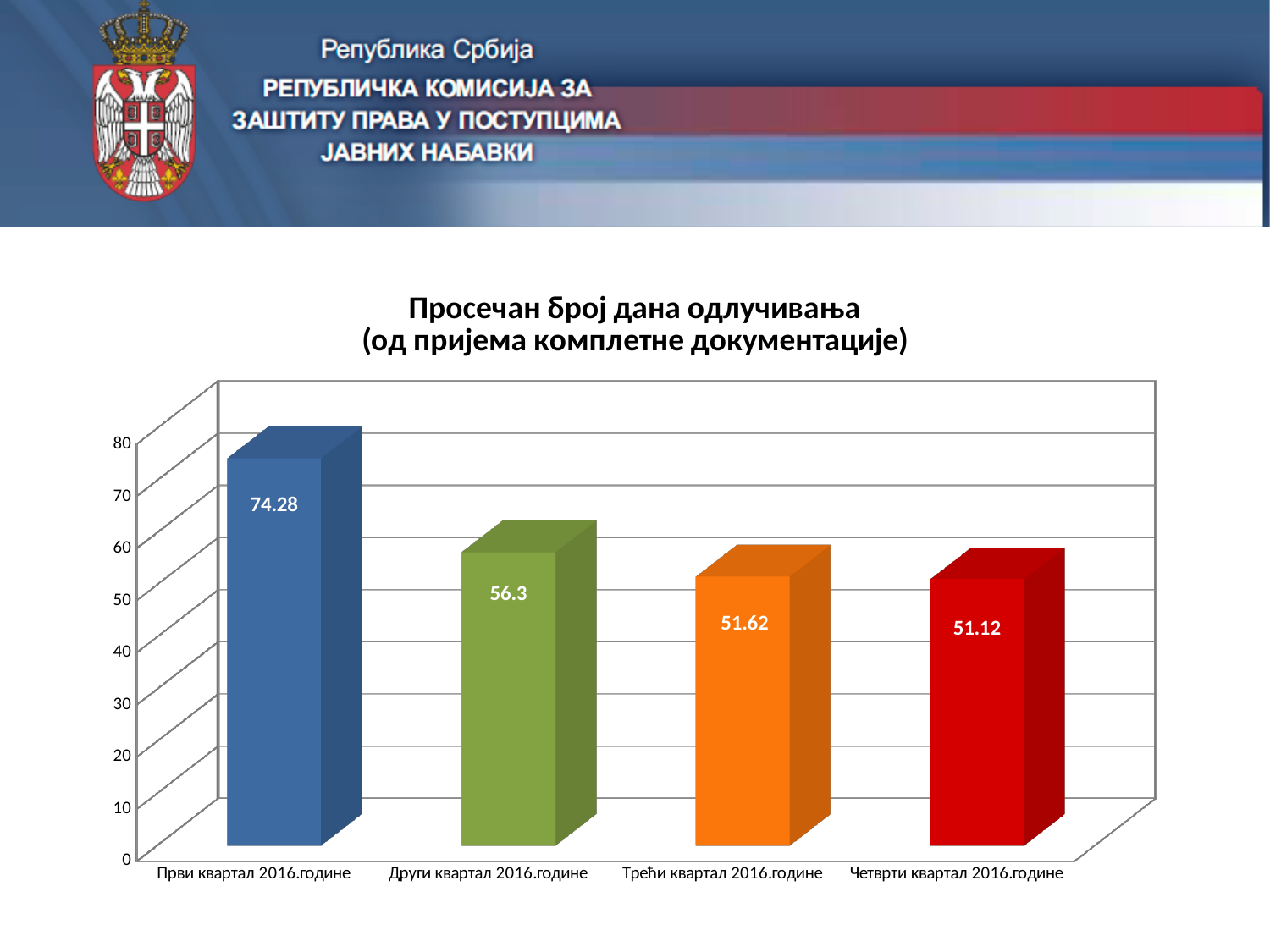
Do the values rise or fall from the first quarter to the fourth quarter? fall What is the value for Први квартал 2016.године? 74.28 What is the value for Четврти квартал 2016.године? 51.12 Which quarter has the highest value? Први квартал 2016.године Is the value for Први квартал 2016.године greater or less than 70? greater How many categories are shown in the chart? 4 What is the value for Други квартал 2016.године? 56.3 What is the value for Трећи квартал 2016.године? 51.62 Which is larger, the value for Други квартал 2016.године or Трећи квартал 2016.године? Други квартал 2016.године Which quarter has the lowest value? Четврти квартал 2016.године What kind of chart is shown on the slide? bar chart What is the difference between the values for Први квартал 2016.године and Други квартал 2016.године? 17.98